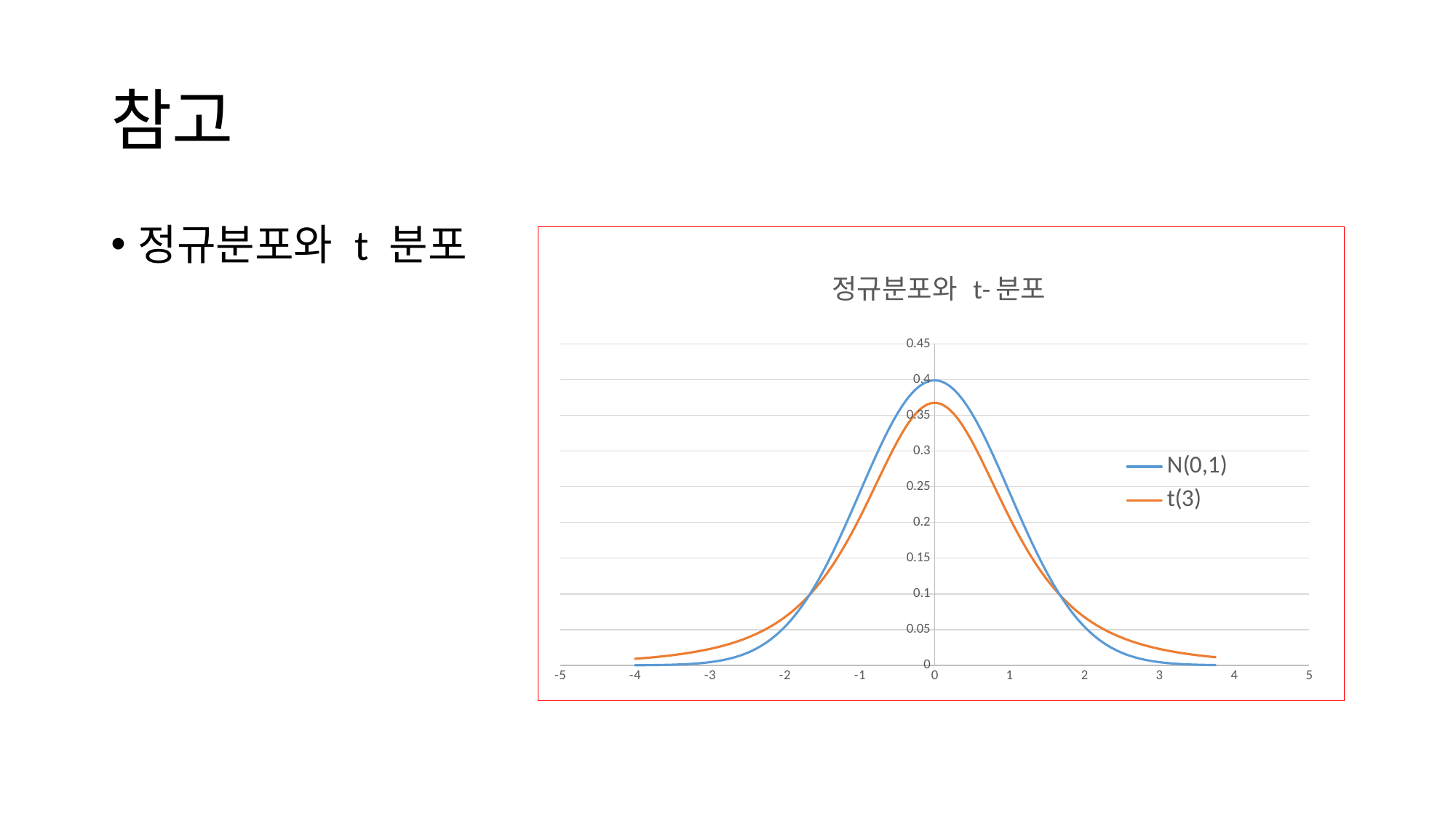
Which series reaches the higher peak value? N(0,1) At x = 3, which series has the larger value, N(0,1) or t(3)? t(3) Does the N(0,1) curve rise or fall as x goes from 0 to 4? fall What kind of chart is shown on the slide? line chart At x = 0, which series has the larger value, N(0,1) or t(3)? N(0,1) Is the value of t(3) at x = 3 greater or less than 0.05? less How many series does the chart's legend list? 2 What is the title of the chart? 정규분포와 t- 분포 Is the value of t(3) at x = 0 greater or less than 0.4? less Which series is drawn in orange in the chart? t(3) Is the value of N(0,1) at x = 0 greater or less than 0.35? greater At x = -3, which series has the larger value, N(0,1) or t(3)? t(3)